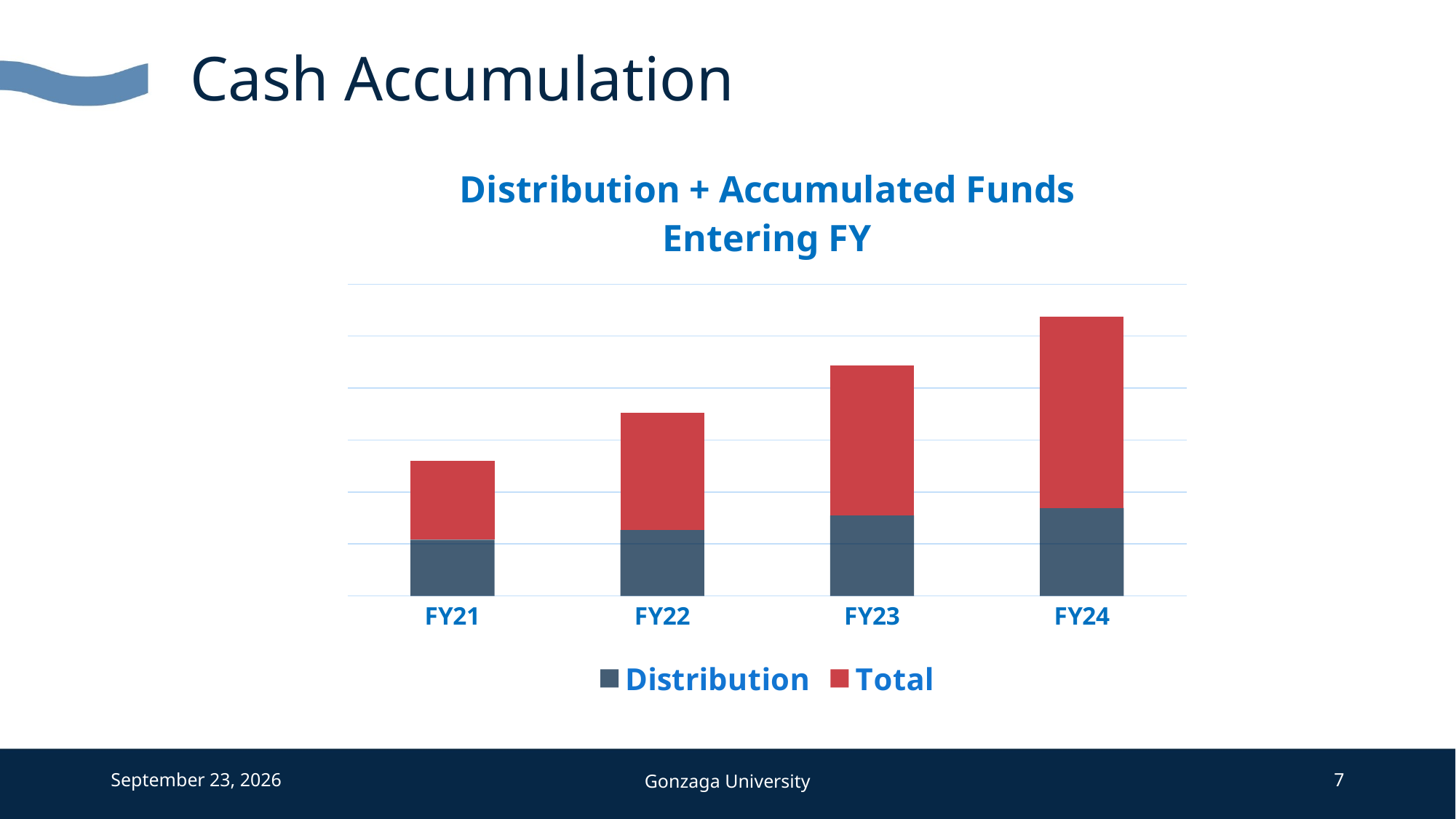
Which fiscal year has the shortest stacked bar? FY21 Which fiscal year has the largest red (Total) segment? FY24 Is the stacked bar for FY23 taller or shorter than the stacked bar for FY22? Taller How many fiscal years are shown on the x axis of the chart? 4 Which fiscal year has the tallest stacked bar? FY24 Which series are listed in the chart legend? Distribution and Total Is the Distribution segment for FY24 larger or smaller than the Distribution segment for FY21? Larger Do the stacked bar heights rise or fall from FY21 to FY24? Rise Which fiscal year has the smallest red (Total) segment? FY21 What kind of chart is shown on the slide? Stacked bar chart What is the title of the chart? Distribution + Accumulated Funds Entering FY How many series does the chart legend list? 2